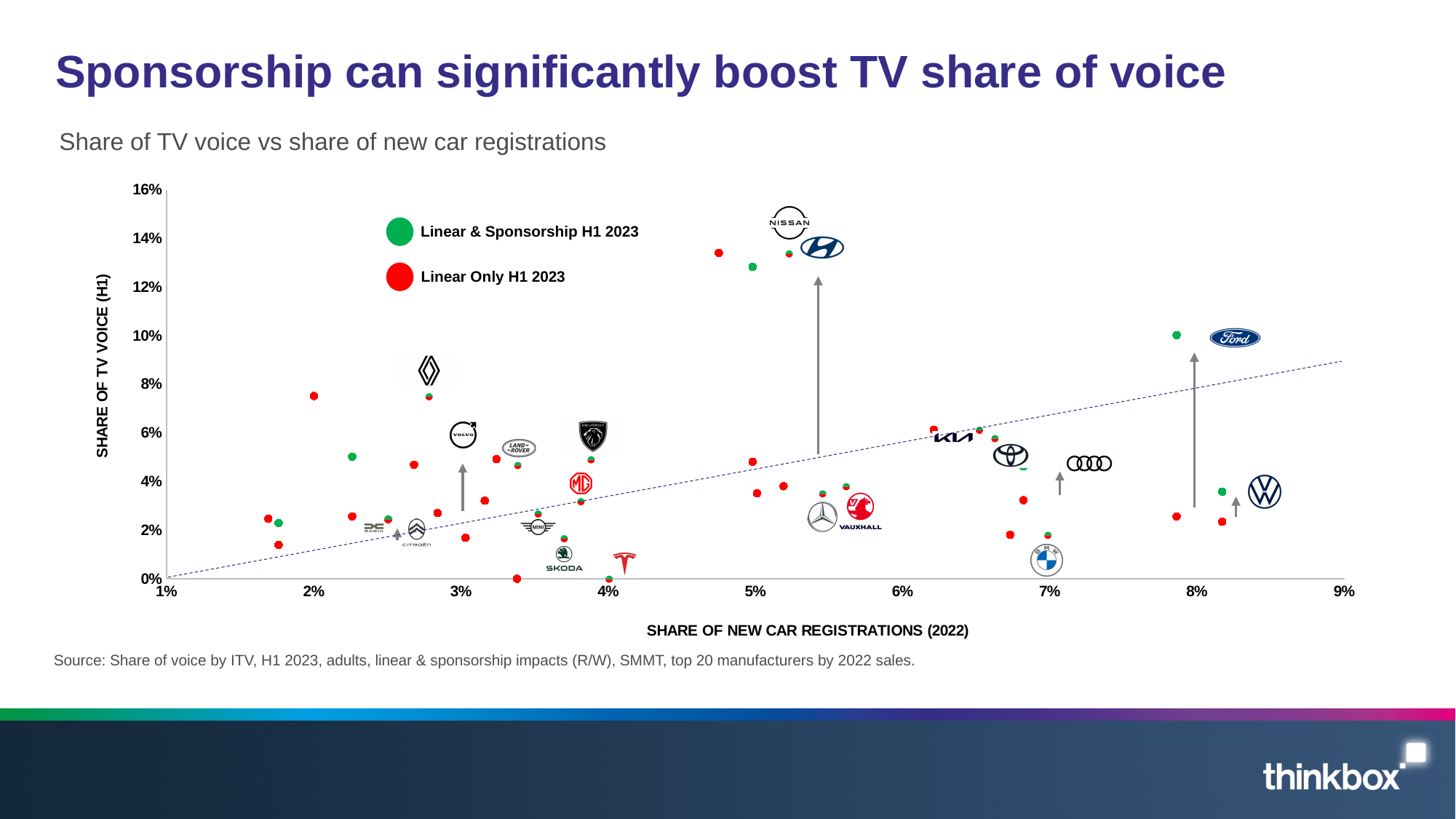
Which series is shown with green markers? Linear & Sponsorship H1 2023 What is the title of the x axis? SHARE OF NEW CAR REGISTRATIONS (2022) Which has the higher Linear & Sponsorship H1 2023 share of TV voice, Ford or VW? Ford Is Ford's Linear Only H1 2023 share of TV voice greater or less than 4%? less Does the dashed trend line rise or fall from left to right? Rise Is Ford's share of new car registrations greater or less than 7%? greater How many car manufacturers are plotted on the chart? 20 How many series does the legend list? 2 Is Ford's Linear & Sponsorship H1 2023 share of TV voice greater or less than 8%? greater What kind of chart is shown on the slide? Scatter chart